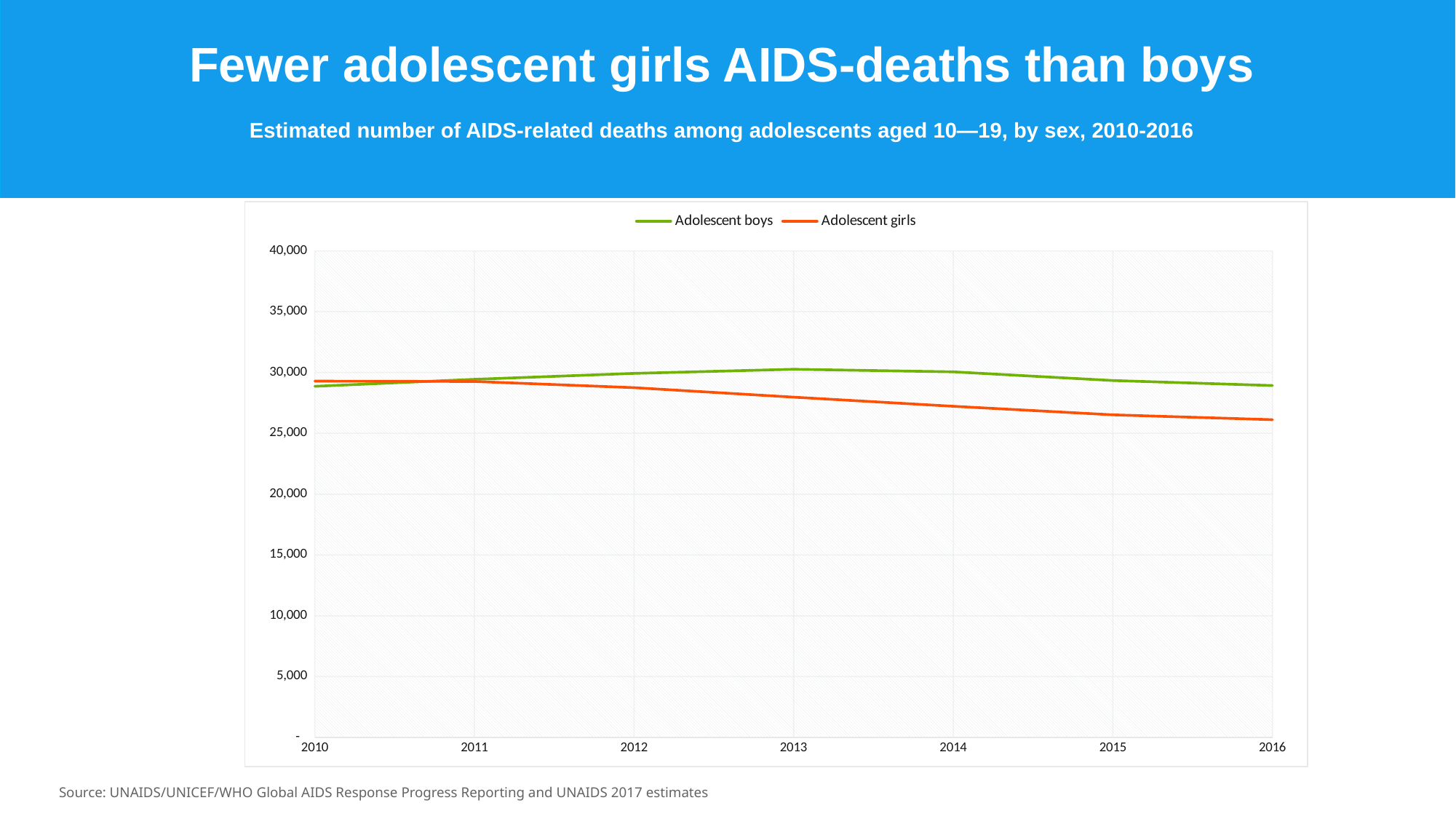
Which series is drawn in orange? Adolescent girls Do the values for Adolescent girls rise or fall from 2011 to 2016? fall What kind of chart is shown on the slide? Line chart How many years are plotted along the x axis? 7 In 2016, which series has the higher value, Adolescent boys or Adolescent girls? Adolescent boys Is the value for Adolescent boys in 2016 greater or less than 25,000? greater Is the value for Adolescent girls in 2016 greater or less than 25,000? greater In 2014, which series has the higher value, Adolescent boys or Adolescent girls? Adolescent boys How many series does the legend list? 2 Is the value for Adolescent girls in 2016 greater or less than 30,000? less What is the title of the slide? Fewer adolescent girls AIDS-deaths than boys In which year is the value for Adolescent girls lowest? 2016